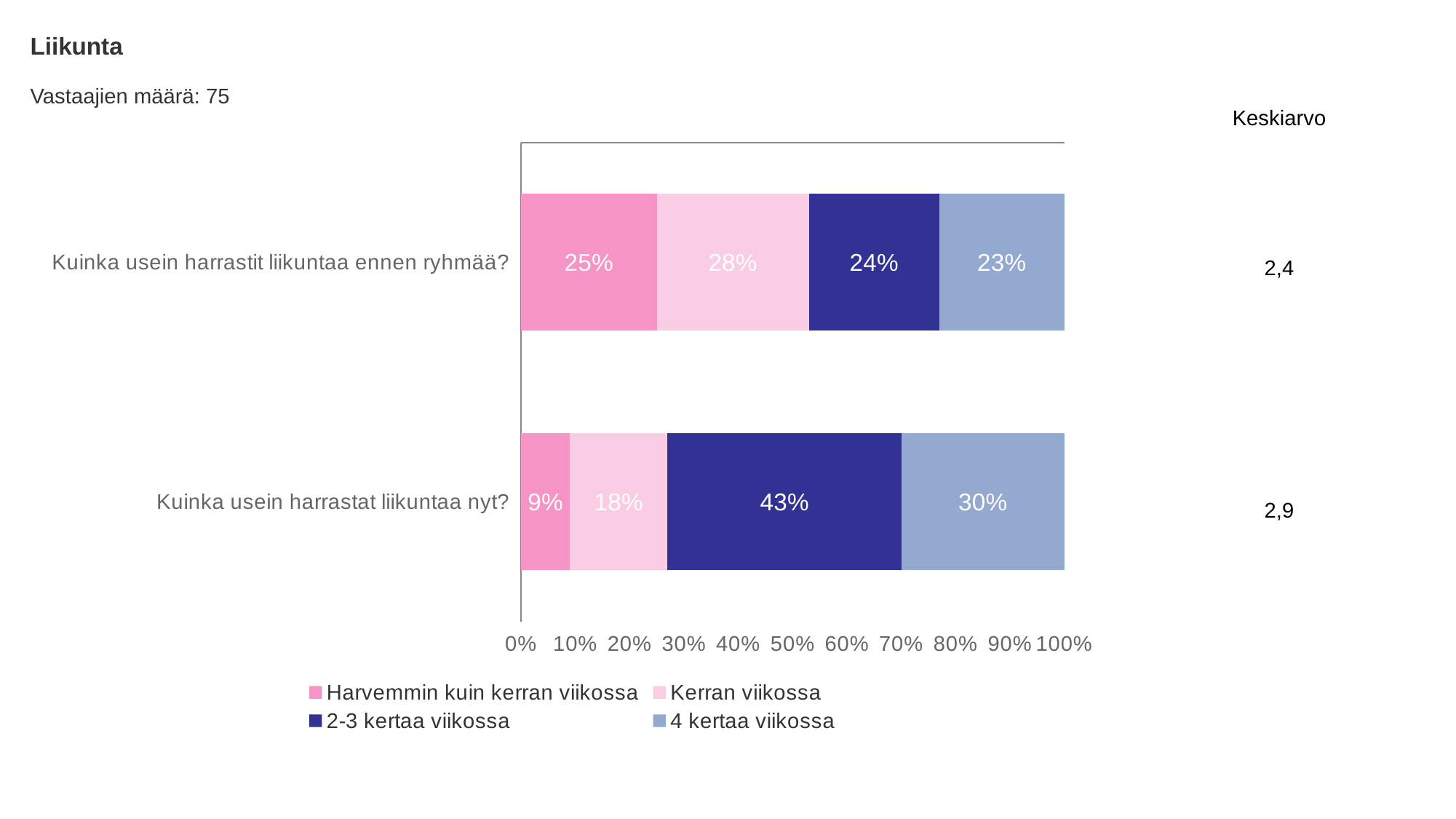
How many respondents (Vastaajien määrä) are reported on the slide? 75 Which response category has the largest share in the bar for "Kuinka usein harrastat liikuntaa nyt?"? 2-3 kertaa viikossa How many questions (categories) are plotted in the chart? 2 Which is larger: the "Kerran viikossa" share for "Kuinka usein harrastit liikuntaa ennen ryhmää?" or for "Kuinka usein harrastat liikuntaa nyt?"? Kuinka usein harrastit liikuntaa ennen ryhmää? What kind of chart is shown on the slide? Stacked bar chart What percentage of respondents answered "2-3 kertaa viikossa" for "Kuinka usein harrastat liikuntaa nyt?"? 43% What percentage of respondents answered "4 kertaa viikossa" for "Kuinka usein harrastit liikuntaa ennen ryhmää?"? 23% How many series does the legend list? 4 What is the Keskiarvo value shown for "Kuinka usein harrastat liikuntaa nyt?"? 2,9 What percentage of respondents answered "Harvemmin kuin kerran viikossa" for "Kuinka usein harrastit liikuntaa ennen ryhmää?"? 25% What is the difference in percentage points between the "2-3 kertaa viikossa" share for "Kuinka usein harrastat liikuntaa nyt?" and for "Kuinka usein harrastit liikuntaa ennen ryhmää?"? 19 percentage points Which response category has the smallest share in the bar for "Kuinka usein harrastat liikuntaa nyt?"? Harvemmin kuin kerran viikossa